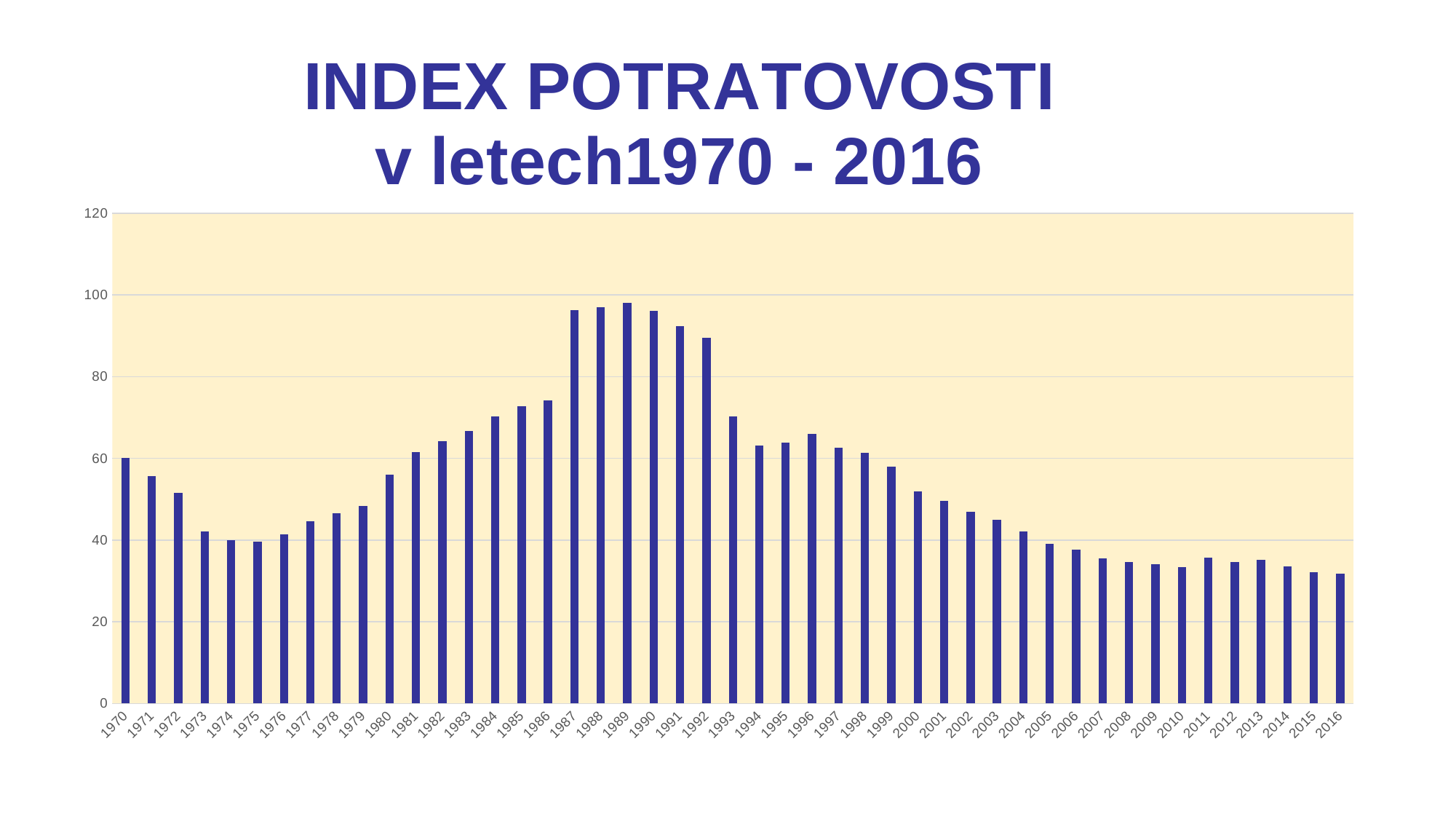
Is the value for 1989 greater or less than 80? greater Do the values rise or fall from 1989 to 2016? fall Is the value for 1985 greater or less than 60? greater What is the title of the chart on the slide? INDEX POTRATOVOSTI v letech1970 - 2016 Is the value for 1980 greater or less than 60? less What kind of chart is shown on the slide? bar chart How many years (bars) are plotted on the chart? 47 Which year has the larger value, 1989 or 1970? 1989 Which year has the larger value, 1975 or 1995? 1995 Which year has the larger value, 1986 or 1996? 1986